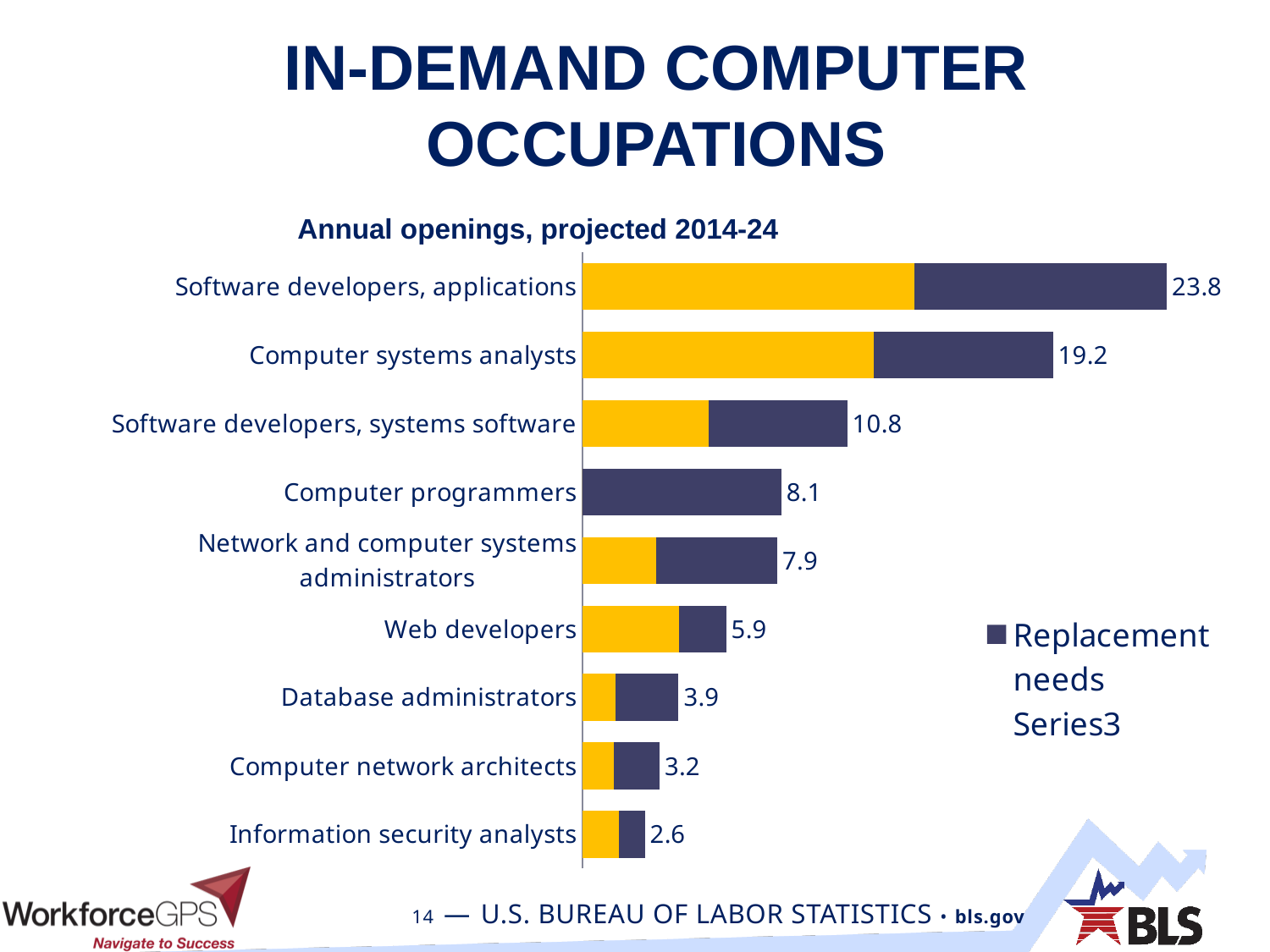
What value is labeled for Computer systems analysts? 19.2 How many entries does the legend list? 2 What is the difference between the labeled values for Software developers, applications and Computer systems analysts? 4.6 What is the title of the chart? Annual openings, projected 2014-24 What value is labeled for Software developers, applications? 23.8 Which has a larger labeled value, Computer programmers or Network and computer systems administrators? Computer programmers How many occupations are shown in the chart? 9 What value is labeled for Information security analysts? 2.6 Which occupation has the highest labeled value? Software developers, applications Which occupation has the lowest labeled value? Information security analysts What value is labeled for Web developers? 5.9 What kind of chart is shown on the slide? Bar chart